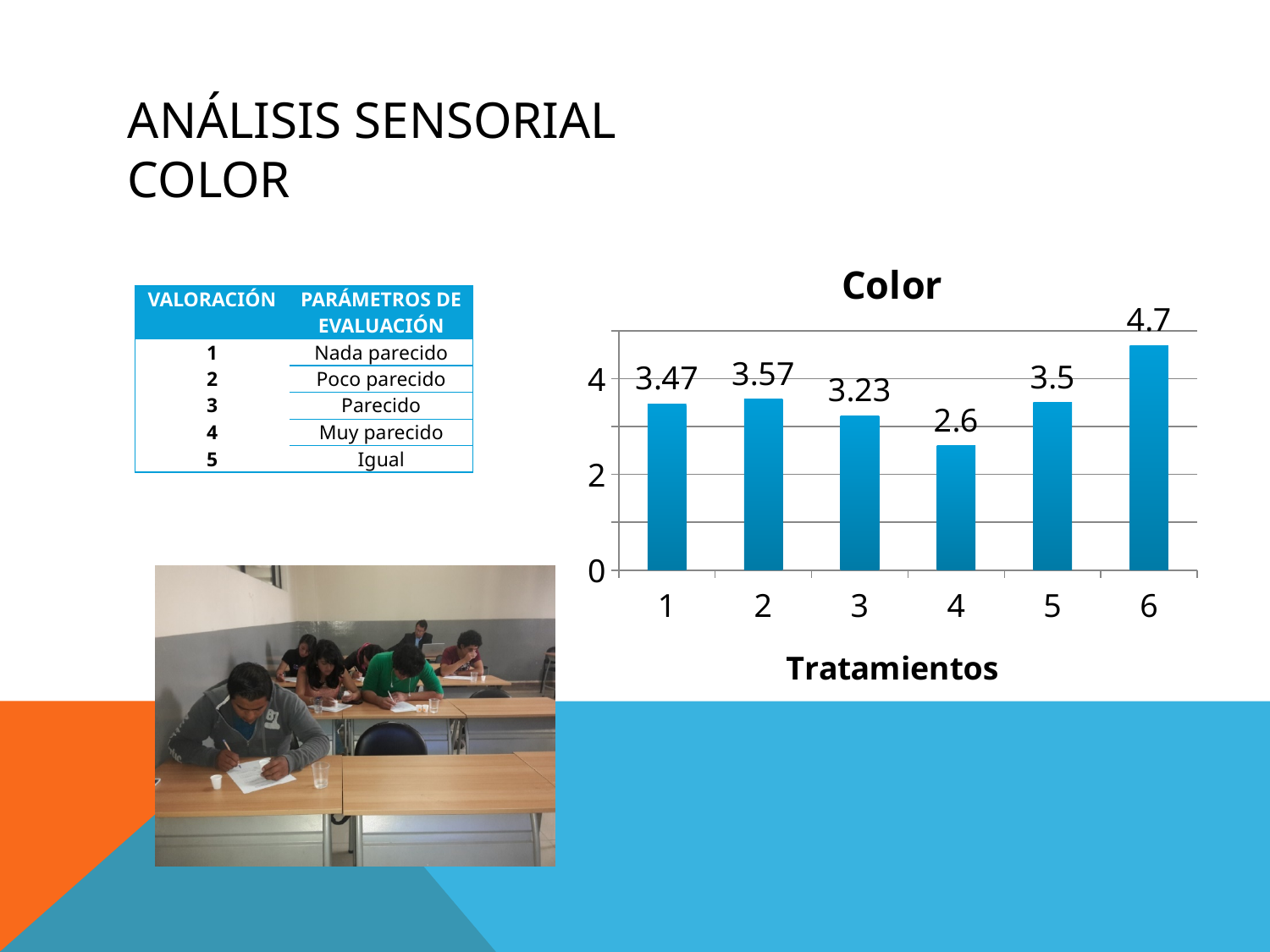
What is the x-axis title of the Color chart? Tratamientos Which has a larger value, treatment 2 or treatment 5? Treatment 2 Which treatment has the lowest value in the Color chart? 4 What is the value for treatment 4 in the Color chart? 2.6 What is the difference between the values for treatment 6 and treatment 4? 2.1 What is the value for treatment 1 in the Color chart? 3.47 What is the value for treatment 6 in the Color chart? 4.7 What kind of chart is the Color chart? Bar chart Is the value for treatment 6 greater or less than 4? greater What is the difference between the values for treatment 2 and treatment 3? 0.34 Which treatment has the highest value in the Color chart? 6 How many treatments are shown in the Color chart? 6